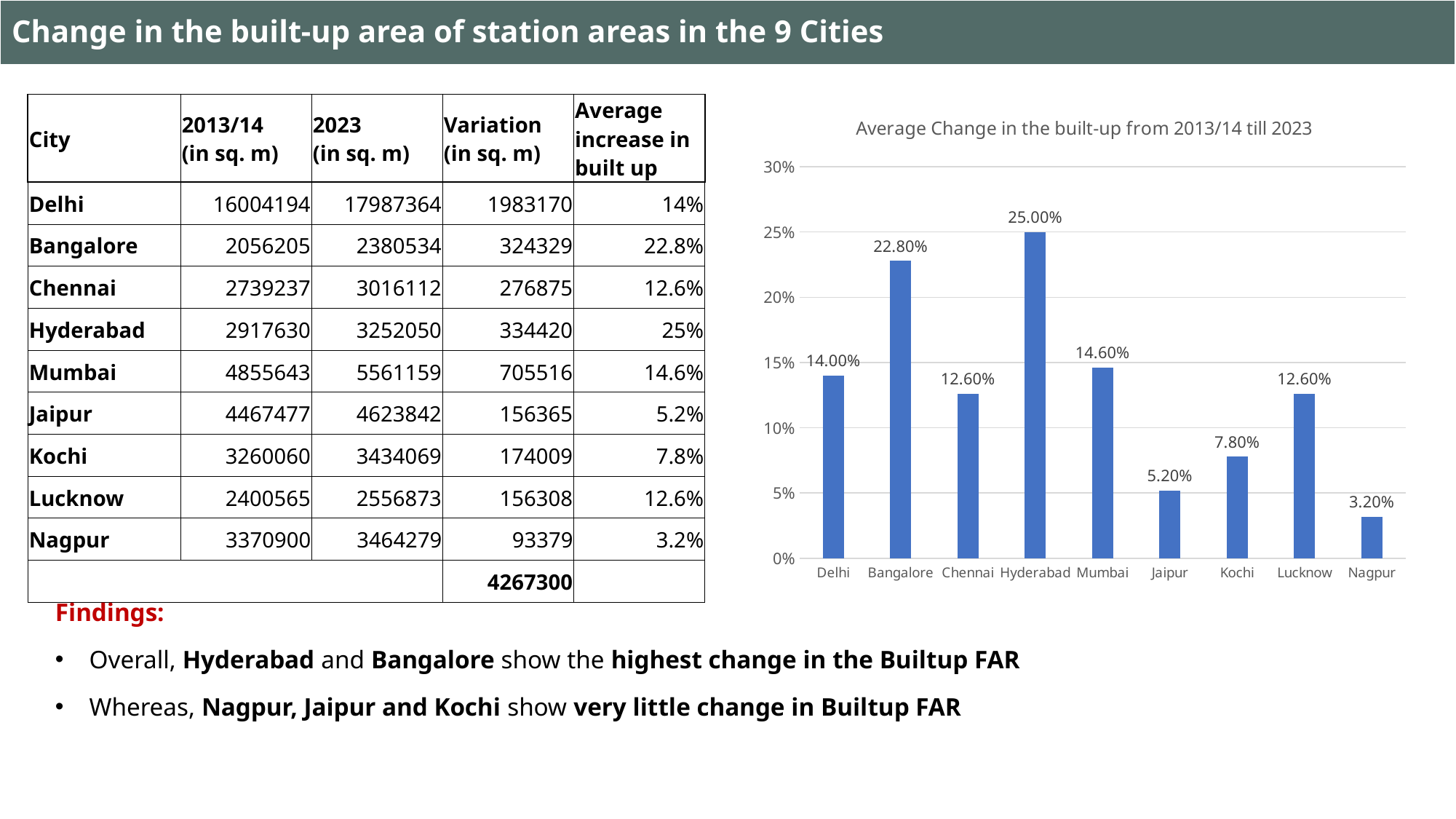
What is the difference between the values for Bangalore and Delhi in the chart? 8.80% Which city has the lowest average change in the chart? Nagpur What is the title of the chart? Average Change in the built-up from 2013/14 till 2023 What is the value for Mumbai in the chart? 14.60% What is the highest value shown on the chart's vertical axis? 30% Which is larger in the chart, the value for Jaipur or the value for Kochi? Kochi Which city has the highest average change in the chart? Hyderabad What kind of chart is shown on the slide? Bar chart What is the value for Kochi in the chart? 7.80% How many cities are shown in the chart? 9 What is the value for Hyderabad in the chart? 25.00% Is the value for Lucknow greater or less than 10%? greater